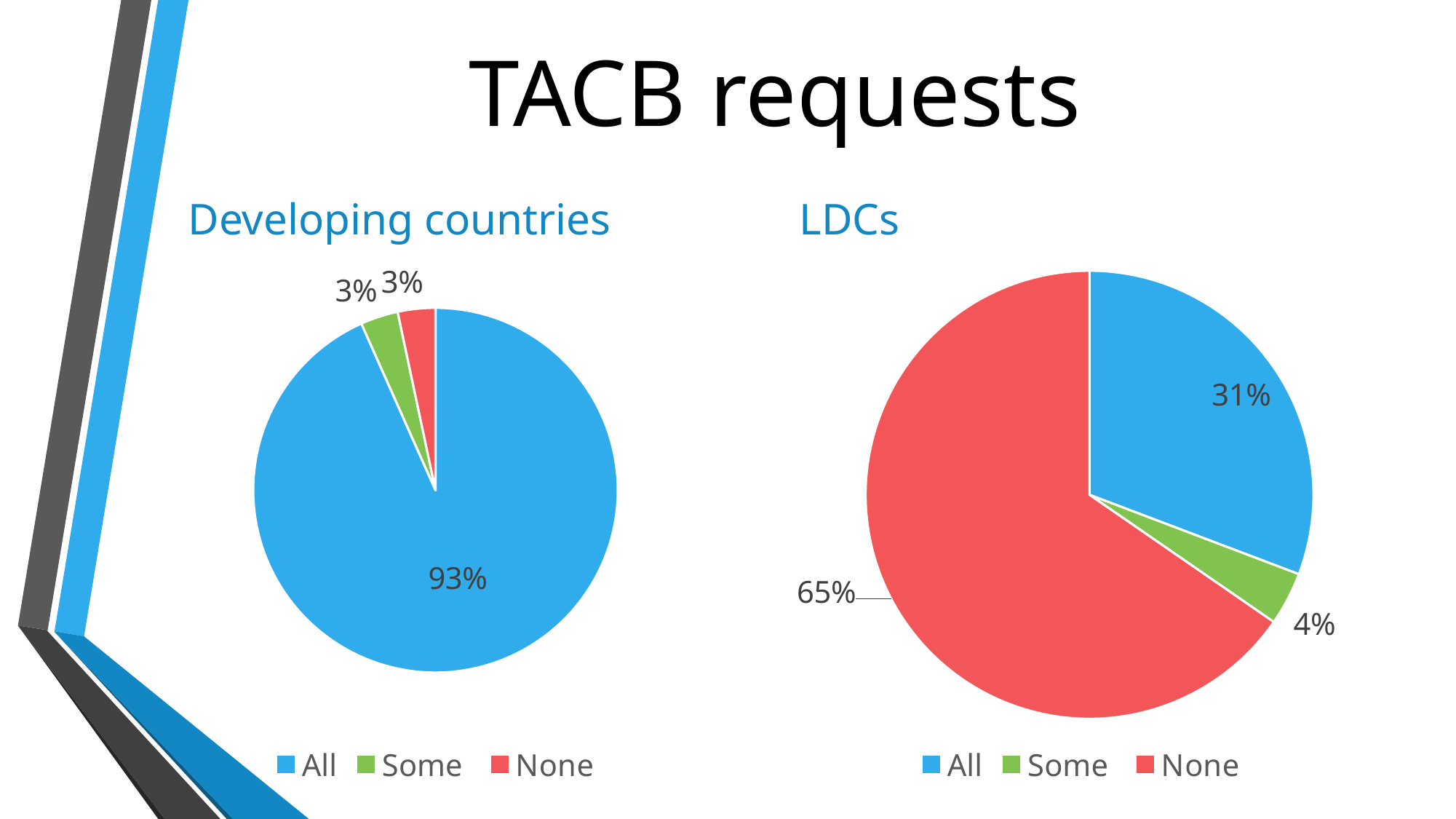
In the LDCs chart, what share of the pie is labelled All? 31% In the Developing countries chart, what share of the pie is labelled Some? 3% In the LDCs chart, what share of the pie is labelled Some? 4% Which chart has the larger share for All, Developing countries or LDCs? Developing countries In the LDCs chart, what is the difference between the None share and the All share? 34% What type of chart is the Developing countries chart? Pie chart In the LDCs chart, which category has the smallest slice? Some How many categories does the legend of the LDCs chart list? 3 In the LDCs chart, which category has the largest slice? None In the LDCs chart, what share of the pie is labelled None? 65% In the Developing countries chart, what share of the pie is labelled All? 93% In the Developing countries chart, which category has the largest slice? All